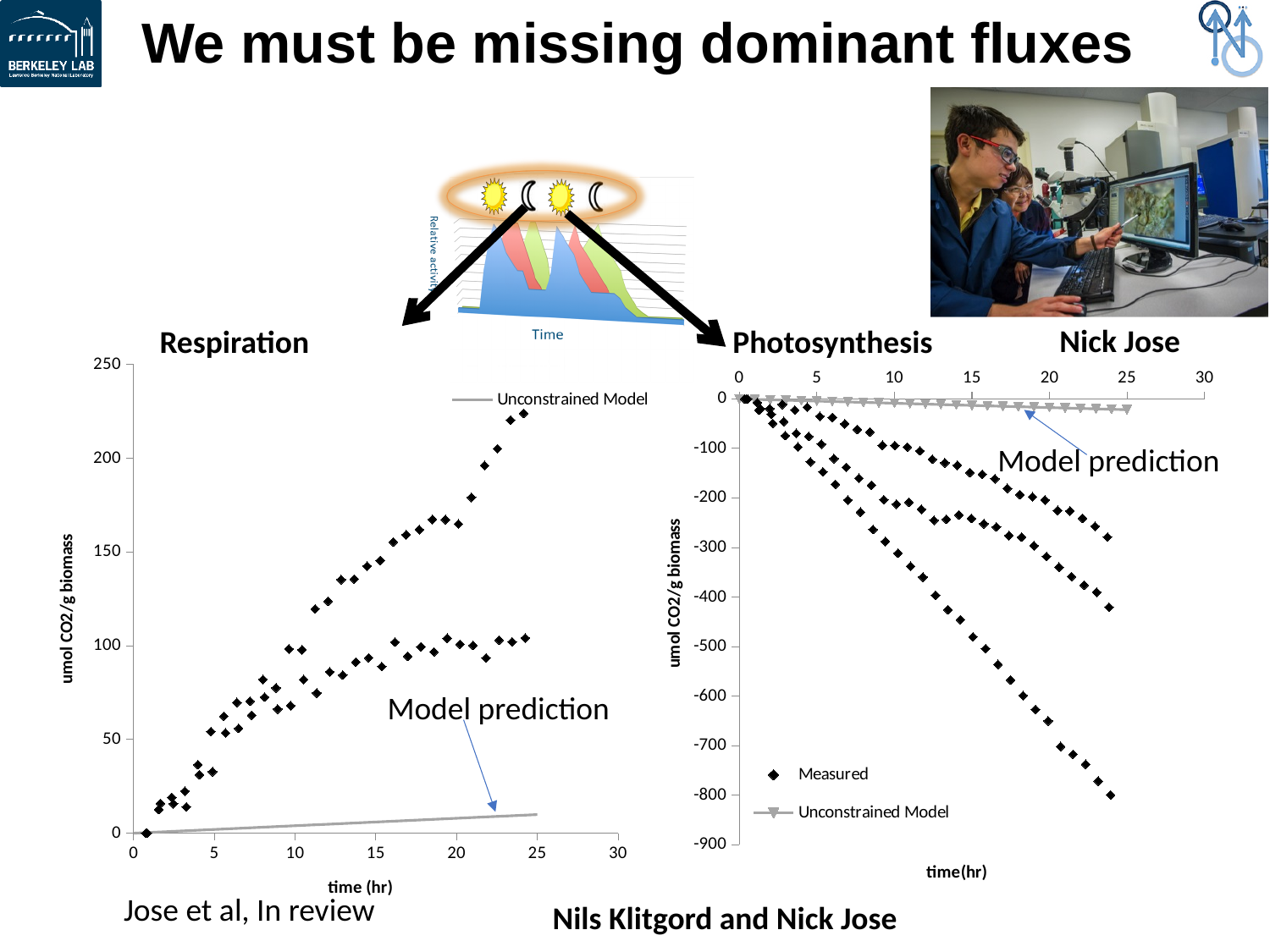
In the Photosynthesis chart, how many series does the legend list? 2 In the Respiration chart, do the measured values rise or fall as time increases? rise In the Respiration chart, is the Unconstrained Model value at 25 hours greater or less than 50? less What is the x-axis title of the Respiration chart? time (hr) In the Respiration chart, is the highest measured value at around 24 hours greater or less than 200? greater What kind of chart is the Photosynthesis chart? scatter chart In the Photosynthesis chart, which series reaches lower values by 25 hours, Measured or Unconstrained Model? Measured What kind of chart is the Respiration chart? scatter chart In the Photosynthesis chart, do the measured values rise or fall as time increases? fall In the Photosynthesis chart, what are the two legend entries? Measured and Unconstrained Model In the Photosynthesis chart, is the lowest measured value at around 24 hours greater or less than -700? less